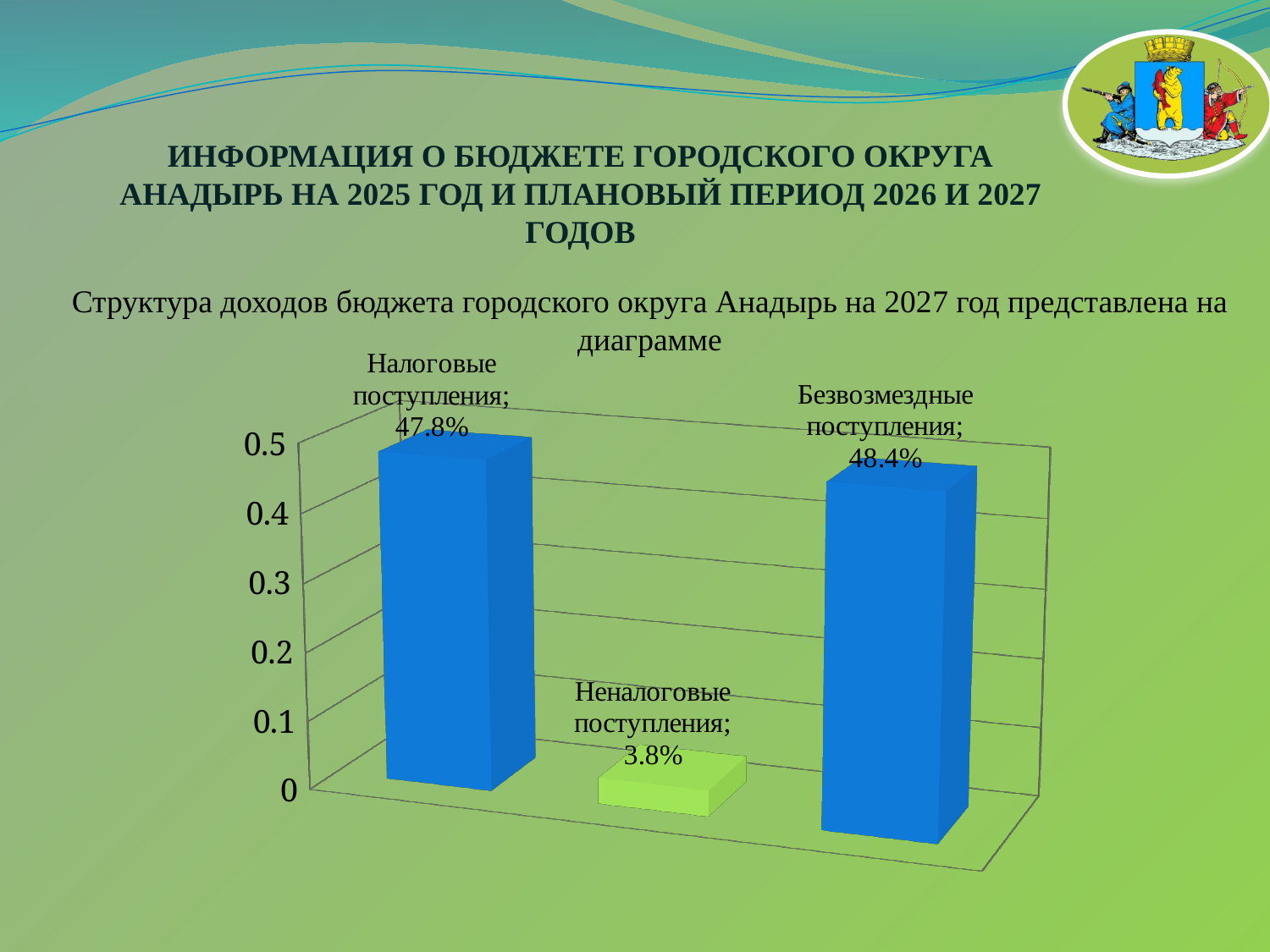
What is the value shown for Неналоговые поступления? 3.8% What kind of chart is shown on the slide? bar chart Which category has the lowest value on the chart? Неналоговые поступления What is the value shown for Налоговые поступления? 47.8% What is the value shown for Безвозмездные поступления? 48.4% What is the difference between the values for Налоговые поступления and Неналоговые поступления? 44.0% What is the difference between the values for Безвозмездные поступления and Налоговые поступления? 0.6% What colour is the bar for Неналоговые поступления? green Which is larger: Налоговые поступления or Безвозмездные поступления? Безвозмездные поступления How many categories are plotted on the chart? 3 Is the bar for Неналоговые поступления greater or less than 0.1 on the axis? less Which category has the highest value on the chart? Безвозмездные поступления